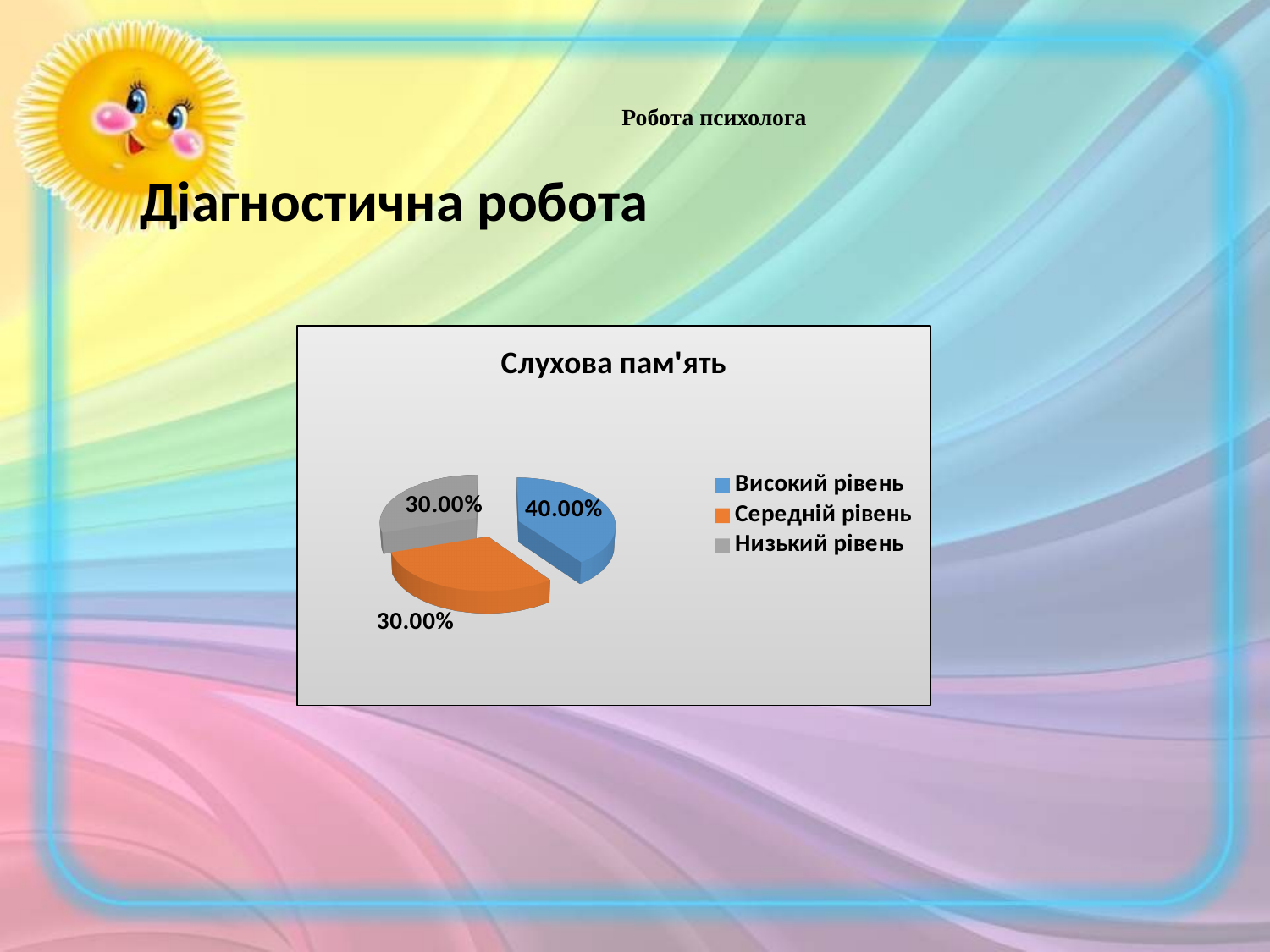
What is the combined share of Середній рівень and Низький рівень? 60.00% What colour is the slice for Середній рівень? orange What is the value for Середній рівень? 30.00% Which is larger, the value for Високий рівень or the value for Низький рівень? Високий рівень What is the title of the chart? Слухова пам'ять What is the value for Низький рівень? 30.00% Which category has the largest share of the pie? Високий рівень How many categories does the legend list? 3 What kind of chart is shown on the slide? pie chart What is the value for Високий рівень? 40.00% What is the difference between the values for Високий рівень and Середній рівень? 10.00%